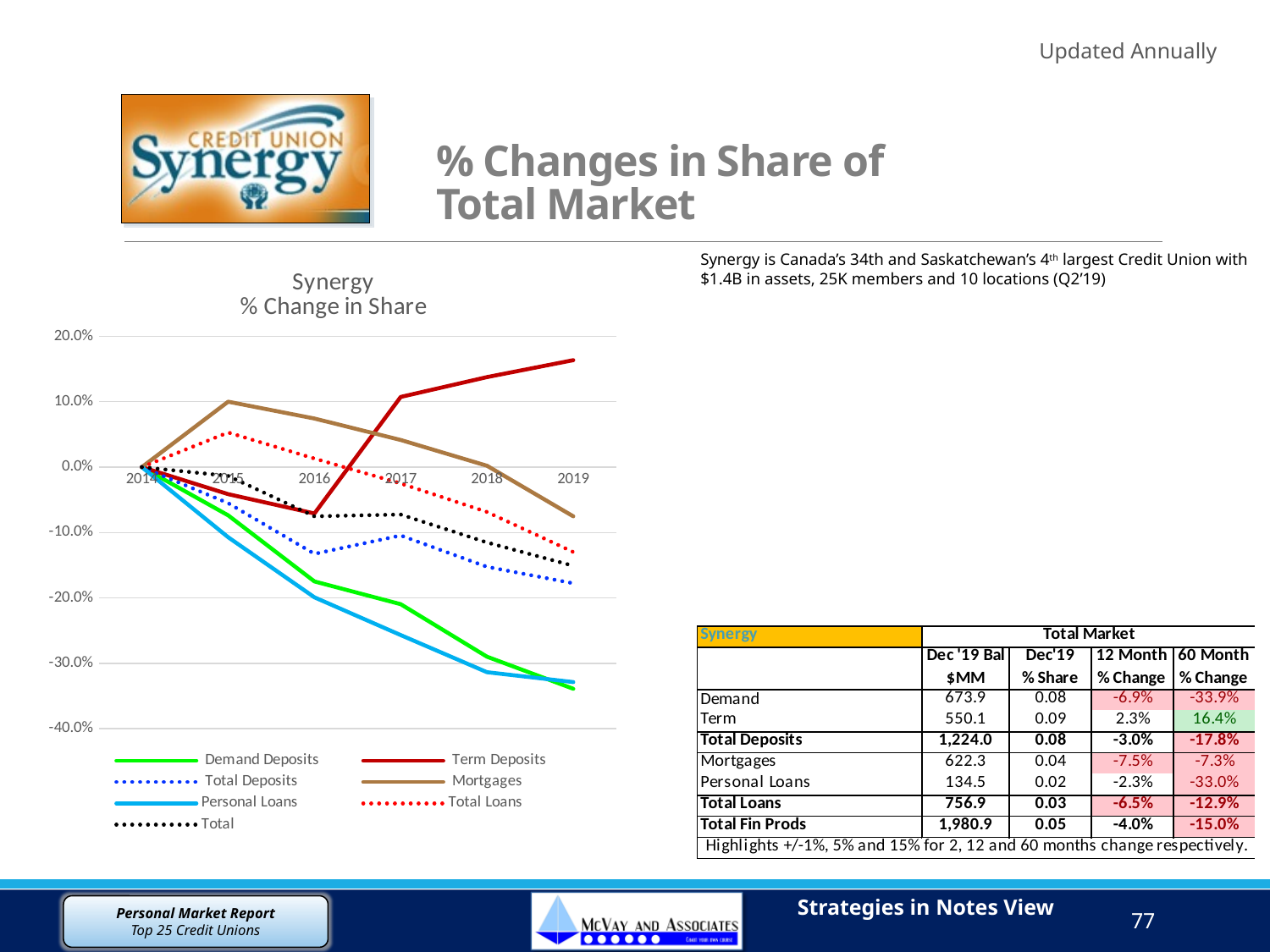
Which series has the highest value in 2019? Term Deposits Which series has the highest value in 2015? Mortgages Is the value for Term Deposits in 2019 greater or less than 10.0%? greater Is the value for Mortgages in 2019 greater or less than 0.0%? less Do the values for Demand Deposits rise or fall from 2014 to 2019? Fall What kind of chart is shown on the slide? Line chart How many years are shown along the x axis of the chart? 6 In 2019, which is larger: Term Deposits or Mortgages? Term Deposits Is the value for Demand Deposits in 2019 greater or less than -30.0%? less How many series does the chart legend list? 7 What is the title of the chart? Synergy % Change in Share